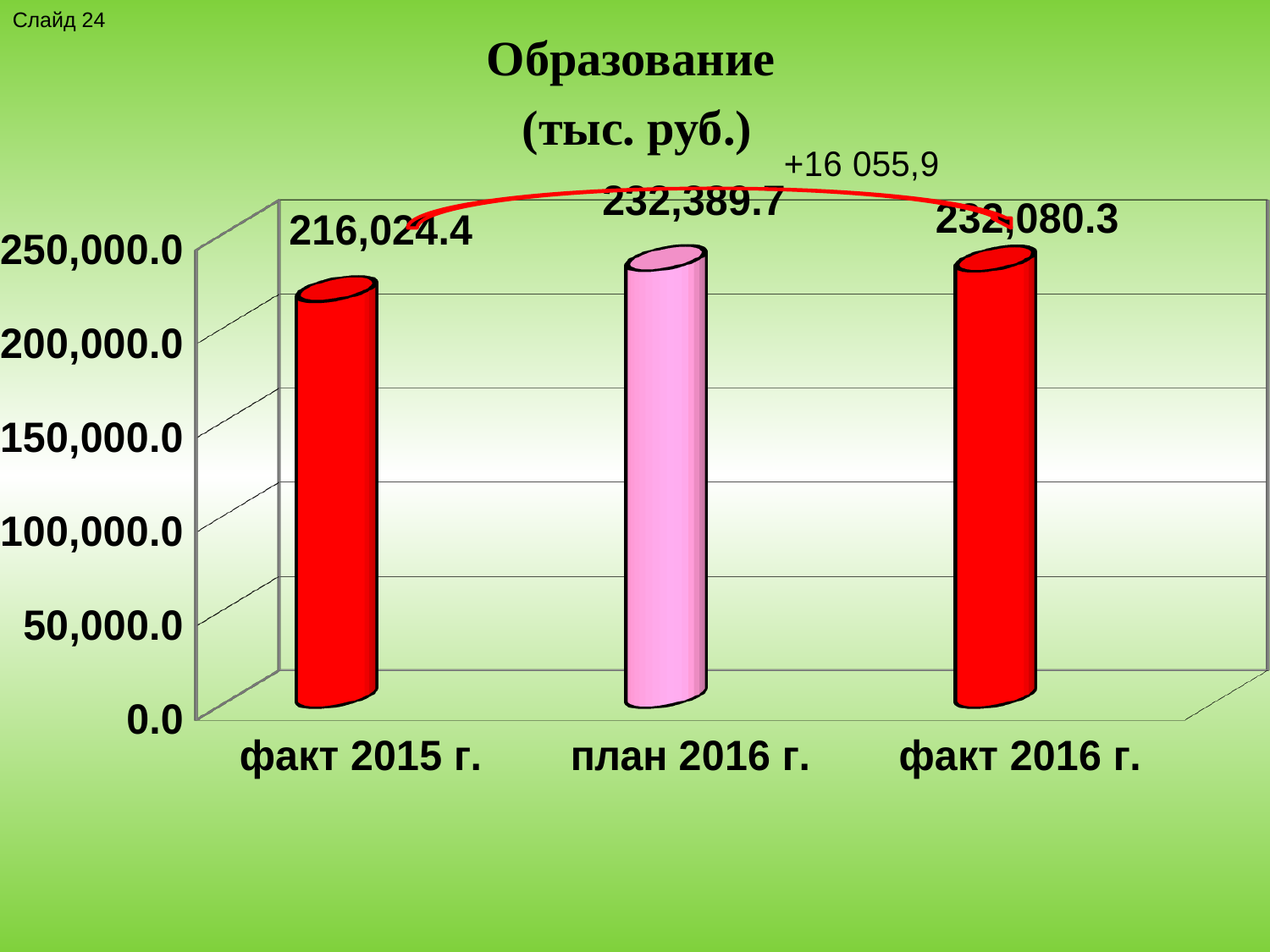
What kind of chart is shown on the slide? bar chart Which is larger, the value for план 2016 г. or факт 2016 г.? план 2016 г. How many categories are shown on the chart? 3 What is the difference between факт 2016 г. and факт 2015 г.? 16,055.9 What is the title of the chart? Образование (тыс. руб.) Which category has the lowest value? факт 2015 г. Is the value for факт 2015 г. greater or less than 200,000.0? greater What is the difference between план 2016 г. and факт 2016 г.? 309.4 What is the value for факт 2015 г.? 216,024.4 Which category has the highest value? план 2016 г. What is the value for факт 2016 г.? 232,080.3 What is the value for план 2016 г.? 232,389.7